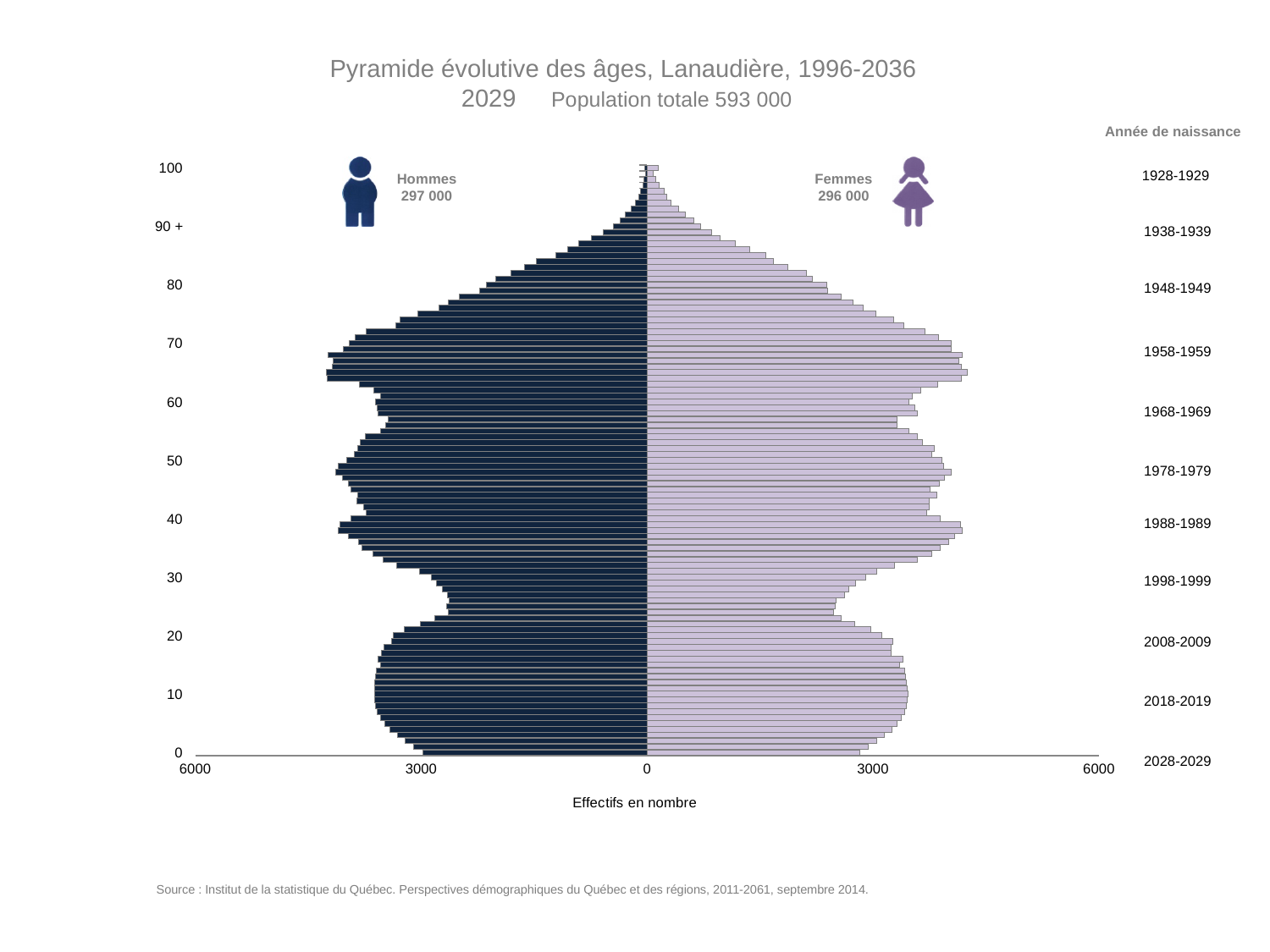
Which group is larger, Hommes or Femmes? Hommes What is the difference between the number of Hommes and the number of Femmes? 1 000 How many series (population groups) does the chart show? 2 What is the number of Hommes shown on the chart? 297 000 Is the value for Femmes at age 65 greater or less than 3000? greater Is the value for Hommes at age 85 greater or less than 3000? less What is the total population shown for 2029? 593 000 What kind of chart is shown on the slide? bar chart Is the value for Hommes at age 65 greater or less than 3000? greater What is the label of the horizontal axis? Effectifs en nombre What is the number of Femmes shown on the chart? 296 000 What is the title of the chart? Pyramide évolutive des âges, Lanaudière, 1996-2036